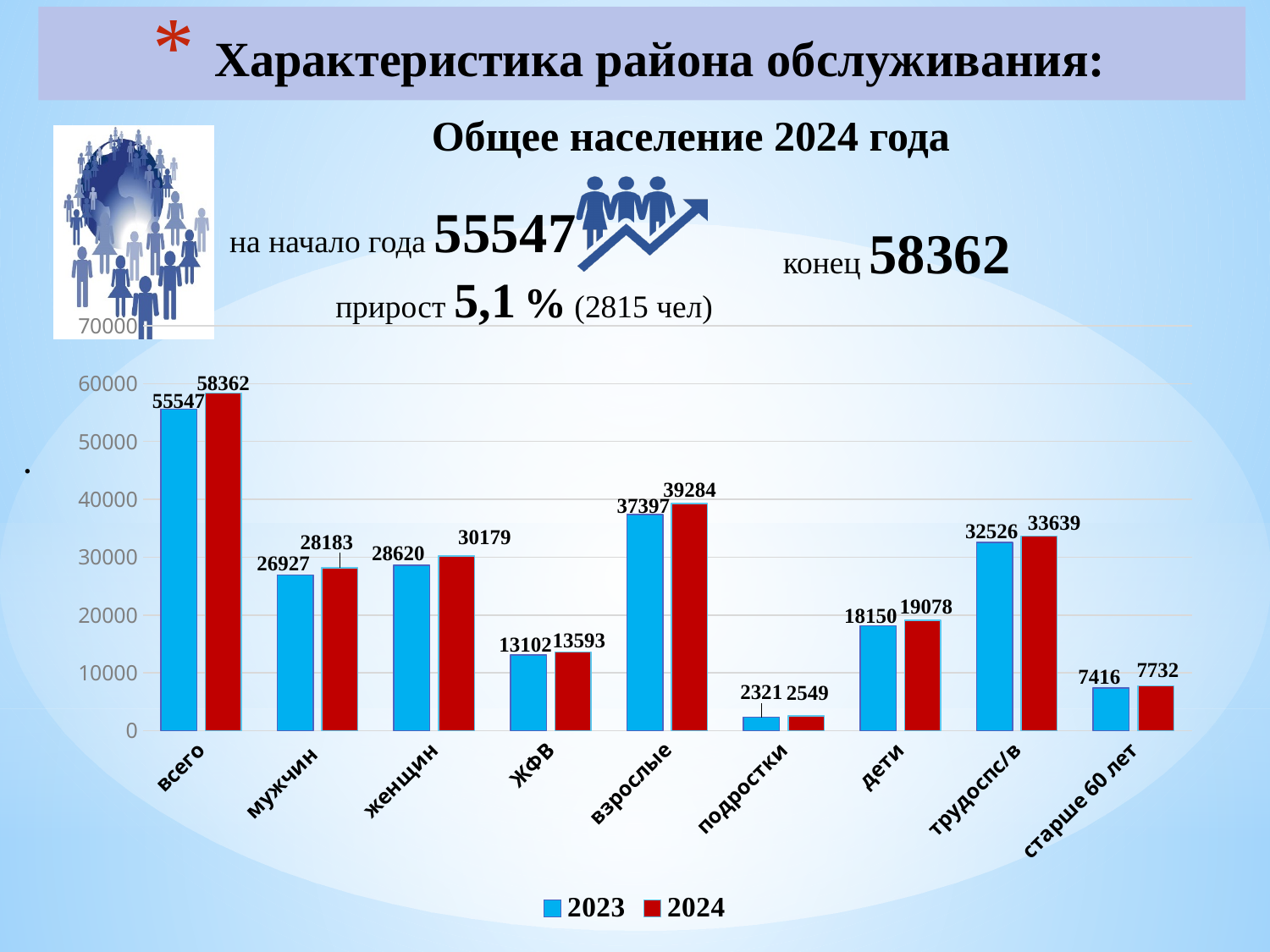
Excluding "всего", which category has the highest value in the 2024 series? взрослые How many categories are shown on the x axis of the chart? 9 Which is larger: the 2023 value for "мужчин" or the 2023 value for "женщин"? женщин What is the difference between the 2024 and 2023 values for "дети"? 928 What is the value for "всего" in the 2024 series? 58362 Is the 2024 value for "старше 60 лет" greater or less than 10000? less Which category has the lowest value in the 2023 series? подростки How many series does the chart legend list? 2 What kind of chart is shown on the slide? bar chart What is the value for "подростки" in the 2024 series? 2549 What is the value for "трудоспс/в" in the 2023 series? 32526 What is the value for "женщин" in the 2023 series? 28620